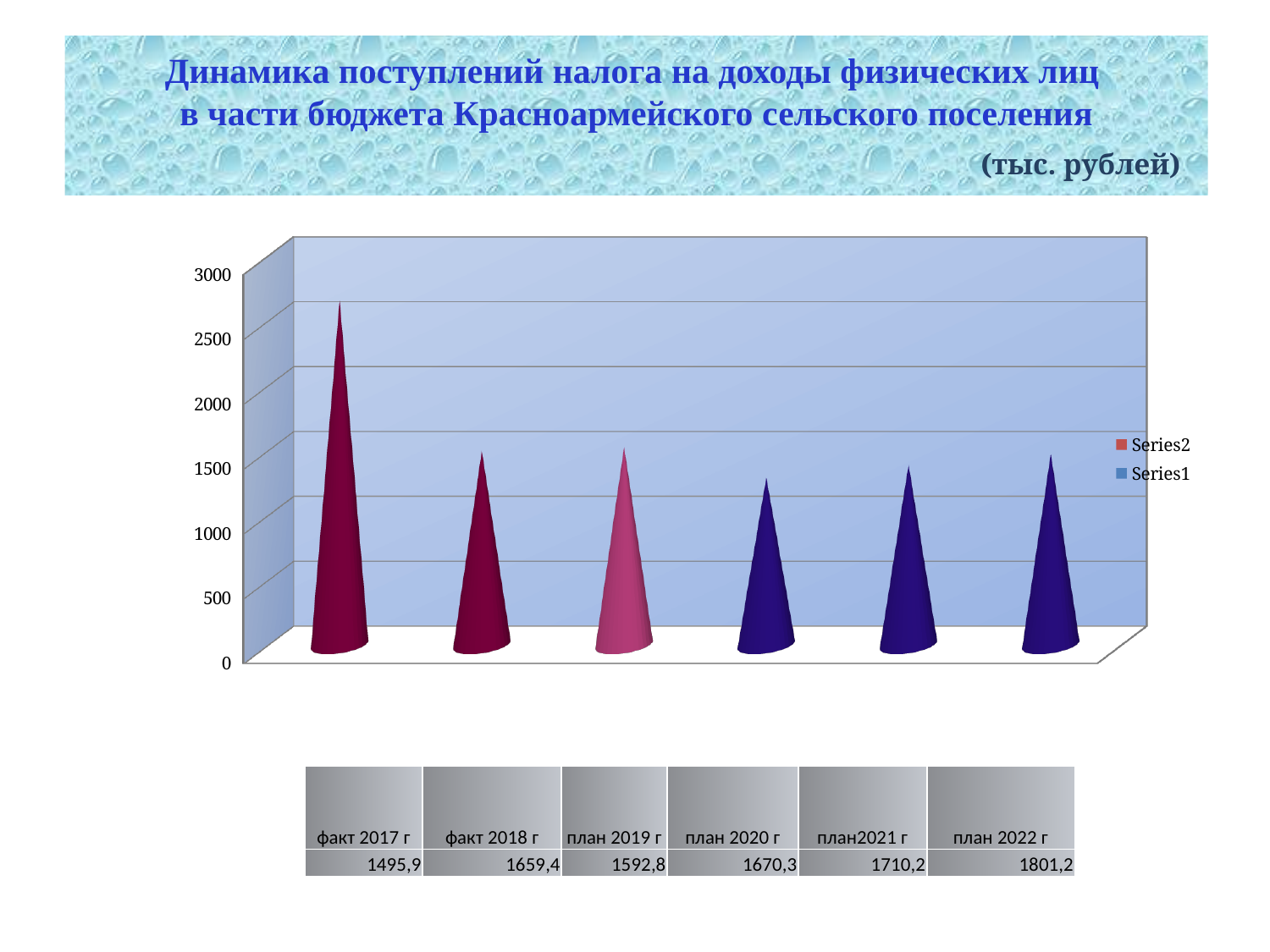
What is the value for факт 2017 г? 1495,9 What is the value for план 2020 г? 1670,3 What is the difference between the values for план 2022 г and факт 2017 г? 305,3 In what units are the values on the slide expressed, according to the title? тыс. рублей What is the value for план 2019 г? 1592,8 What kind of chart is shown on the slide? bar chart What is the difference between the values for факт 2018 г and план 2019 г? 66,6 What is the value for план2021 г? 1710,2 How many categories are shown in the chart? 6 What is the value for факт 2018 г? 1659,4 How many series does the legend list? 2 What is the value for план 2022 г? 1801,2